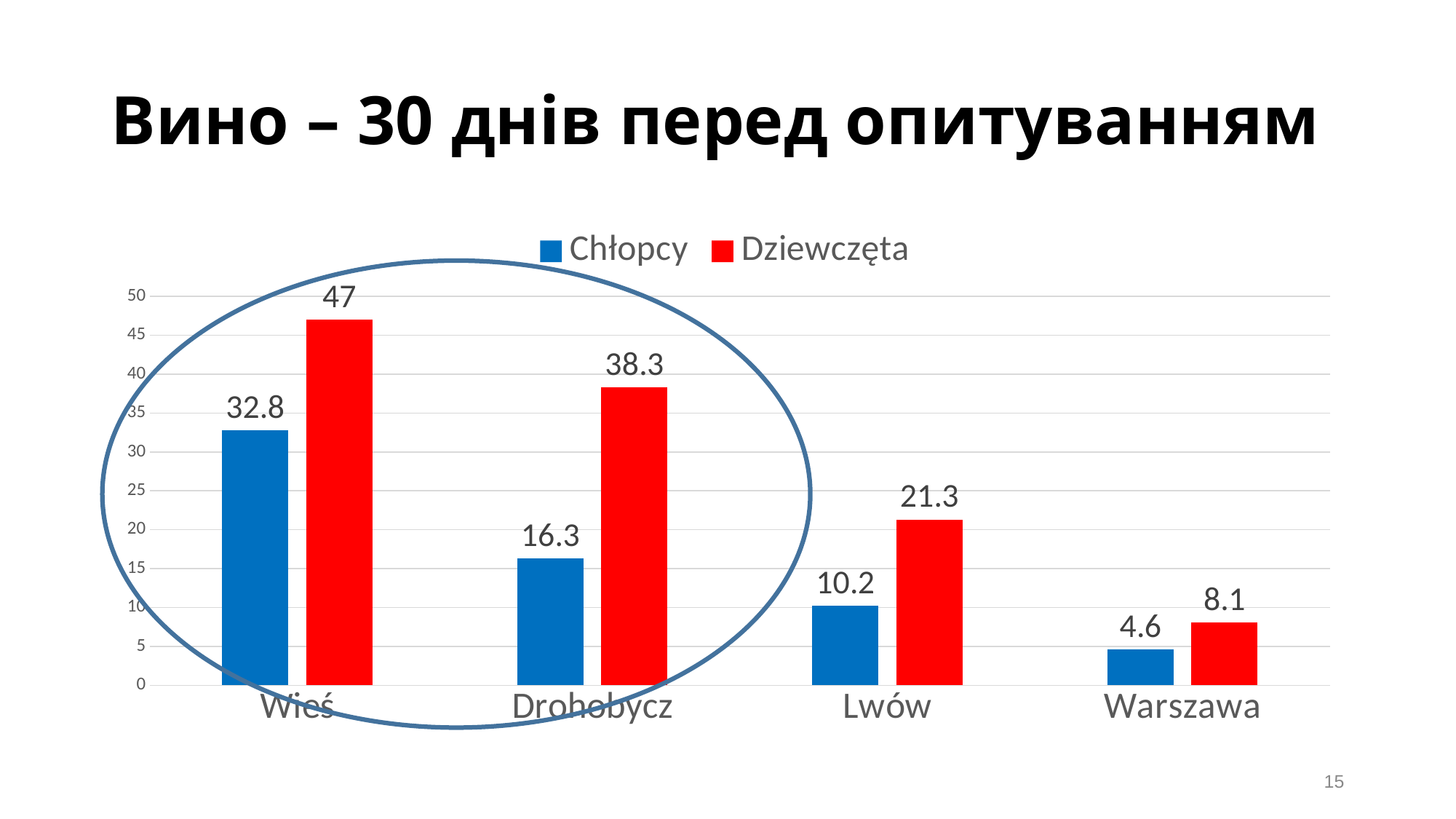
Which category has the highest value for Dziewczęta? Wieś What kind of chart is shown on the slide? bar chart What is the value for Chłopcy in Warszawa? 4.6 What is the value for Dziewczęta in Drohobycz? 38.3 How many series does the legend list? 2 Which category has the lowest value for Chłopcy? Warszawa How many categories are shown on the x axis? 4 What is the difference between Dziewczęta and Chłopcy in Lwów? 11.1 Which is larger in Drohobycz, Chłopcy or Dziewczęta? Dziewczęta What is the value for Chłopcy in Wieś? 32.8 Do the Chłopcy values rise or fall from Wieś to Warszawa? fall Is the value for Dziewczęta in Wieś greater or less than 45? greater